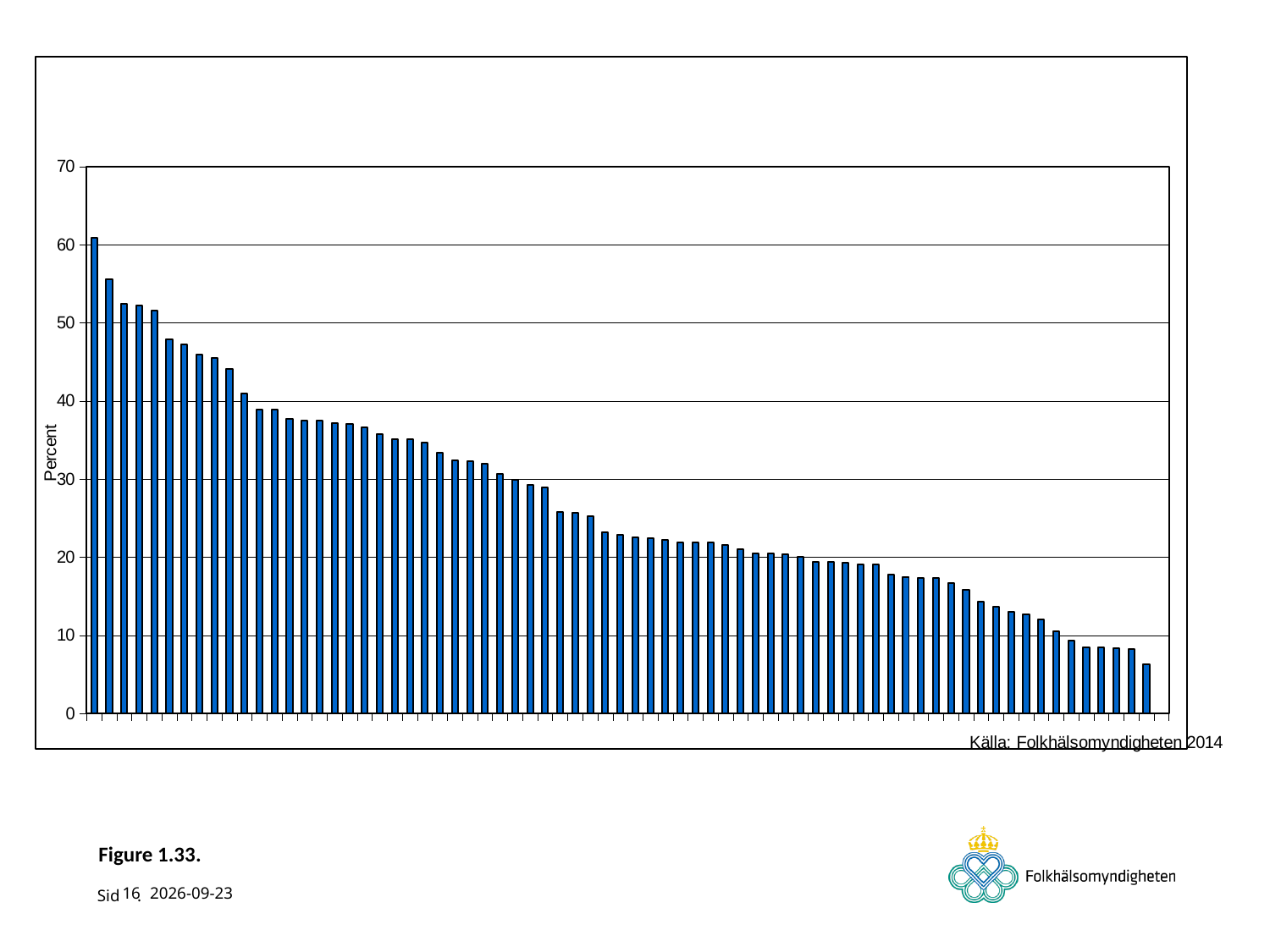
Do the bar values rise or fall from left to right across the chart? fall What is the highest value shown on the vertical axis? 70 What kind of chart is shown on the slide? bar chart Is the value of the second bar from the left greater or less than 50? greater Is the value of the tallest (leftmost) bar greater or less than 50? greater Which bar is the tallest: the leftmost bar or the rightmost bar? the leftmost bar Is the value of the shortest (rightmost) bar greater or less than 10? less What is the label on the vertical axis of the chart? Percent